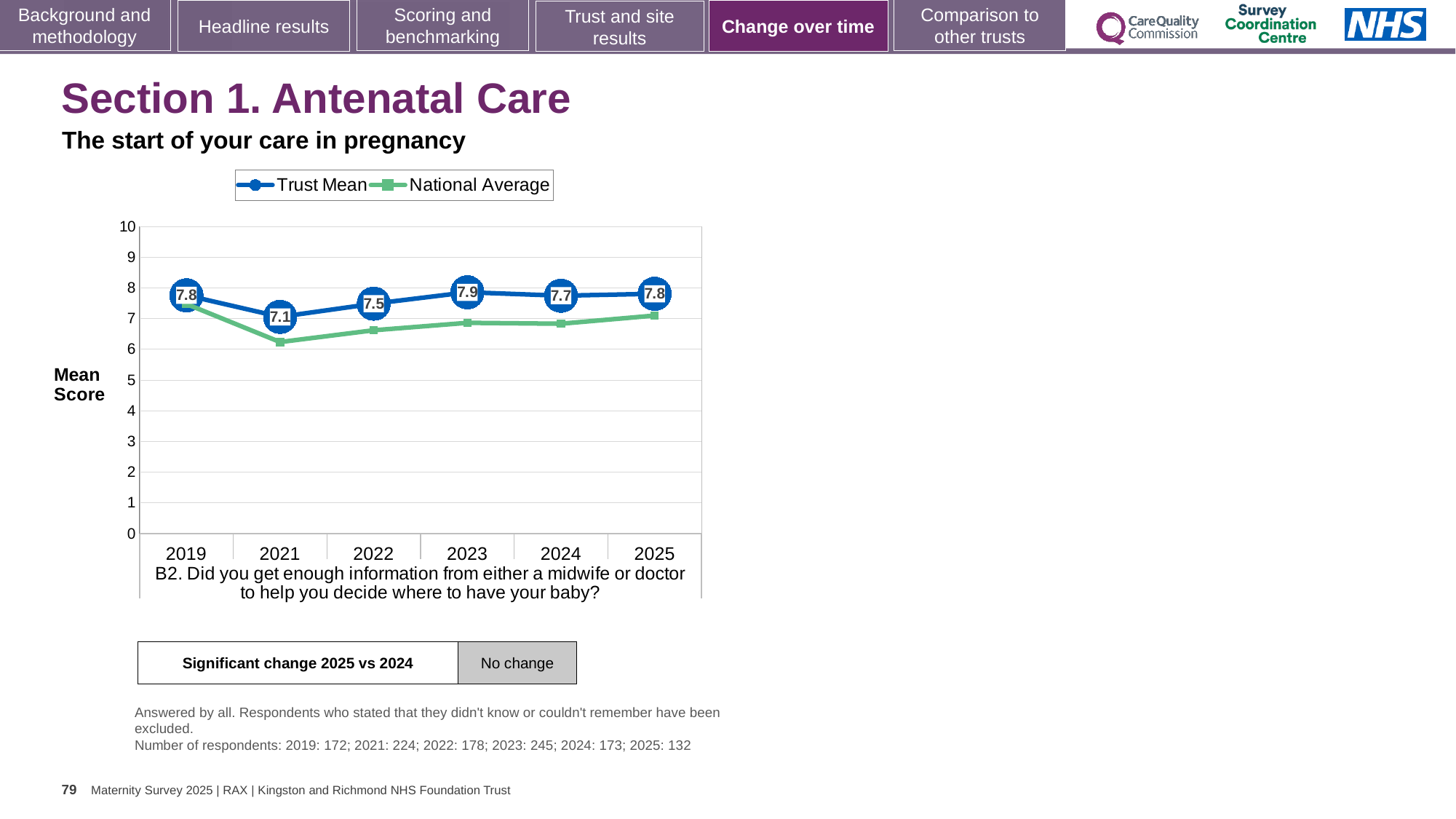
What kind of chart is shown? line chart Which is larger, the Trust Mean in 2022 or in 2024? 2024 What is the Trust Mean score for 2025? 7.8 Is the National Average value for 2021 greater or less than 7? less What is the Trust Mean score for 2021? 7.1 How many years are plotted on the x axis? 6 Does the Trust Mean rise or fall from 2021 to 2023? rise How many series does the legend list? 2 In which year is the Trust Mean highest? 2023 In which year is the Trust Mean lowest? 2021 What is the difference between the Trust Mean in 2023 and in 2021? 0.8 What is the Trust Mean score for 2023? 7.9